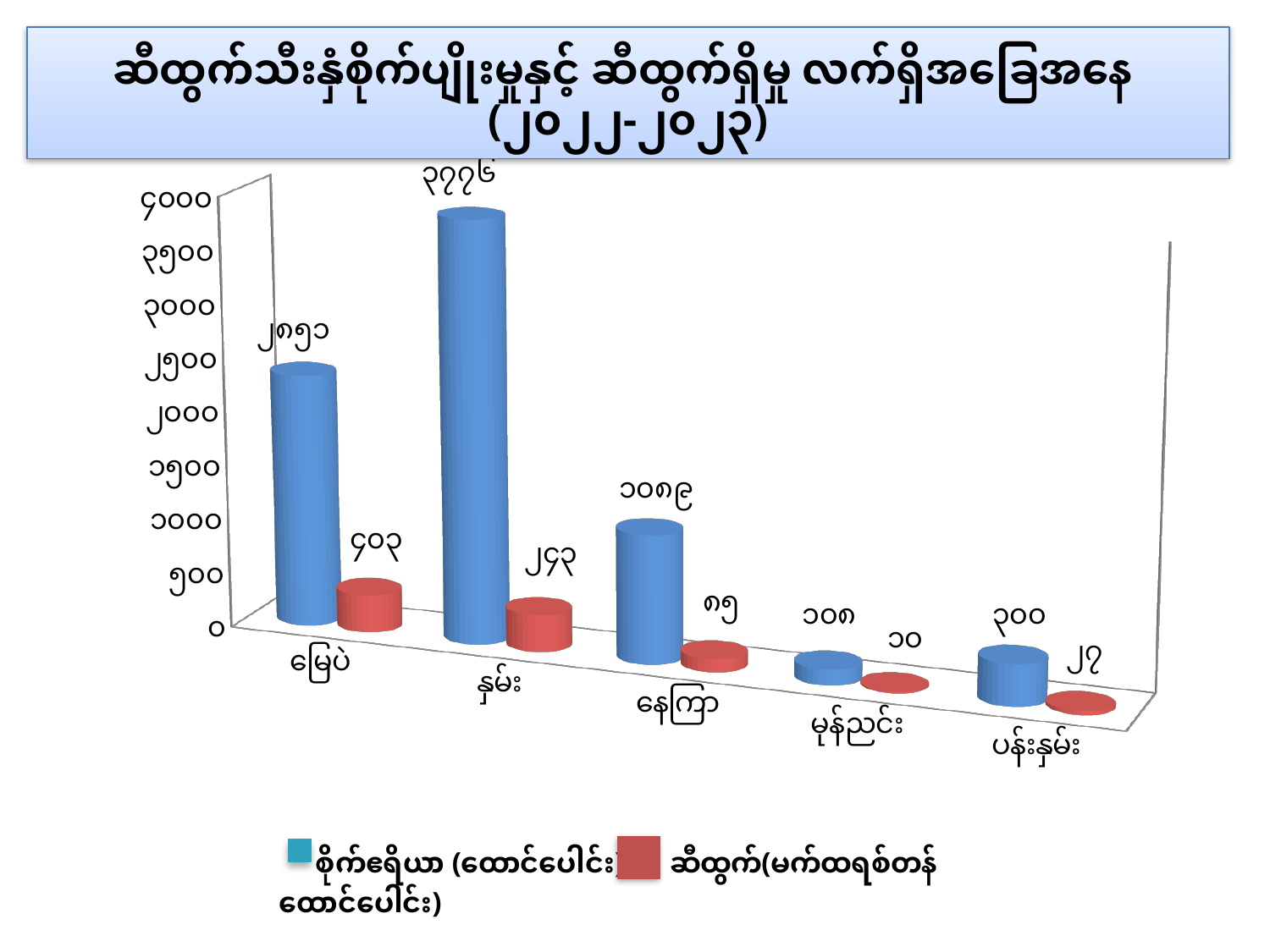
What is the value of the blue series (စိုက်ဧရိယာ) for နှမ်း? ၃၇၇၆ Which category has the highest value in the blue series (စိုက်ဧရိယာ)? နှမ်း Which is larger in the red series (ဆီထွက်): မြေပဲ or နှမ်း? မြေပဲ What is the difference between the blue series values for နှမ်း and မြေပဲ? ၉၂၅ How many categories are shown on the x axis? 5 What is the value of the red series (ဆီထွက်) for မြေပဲ? ၄၀၃ Which category has the lowest value in the red series (ဆီထွက်)? မုန်ညင်း What is the value of the red series (ဆီထွက်) for ပန်းနှမ်း? ၂၇ What type of chart is shown on the slide? bar chart What years are given in the chart title? ၂၀၂၂-၂၀၂၃ How many series does the legend list? 2 What is the value of the blue series (စိုက်ဧရိယာ) for နေကြာ? ၁၀၈၉